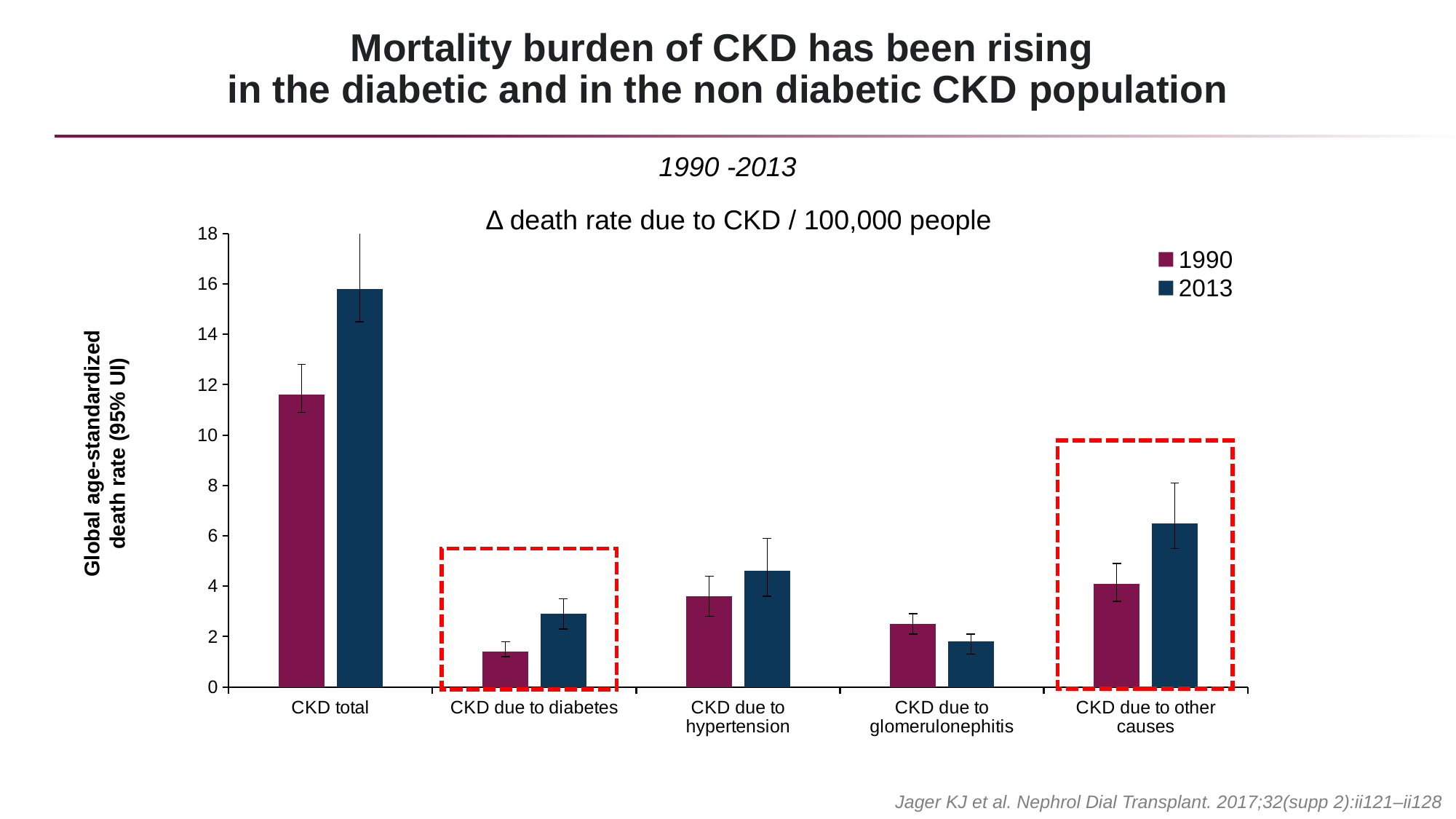
Is the 2013 value for CKD due to other causes greater or less than 6? greater Is the 1990 value for CKD total greater or less than 10? greater Is the 1990 value for CKD due to diabetes greater or less than 2? less What is the label of the y axis? Global age-standardized death rate (95% UI) For CKD due to glomerulonephritis, which year has the larger value, 1990 or 2013? 1990 Which category has the lowest 1990 value? CKD due to diabetes How many series does the legend list? 2 What kind of chart is shown on the slide? bar chart How many categories are shown on the x axis? 5 For CKD due to diabetes, which year has the larger value, 1990 or 2013? 2013 Which category has the highest 2013 value? CKD total